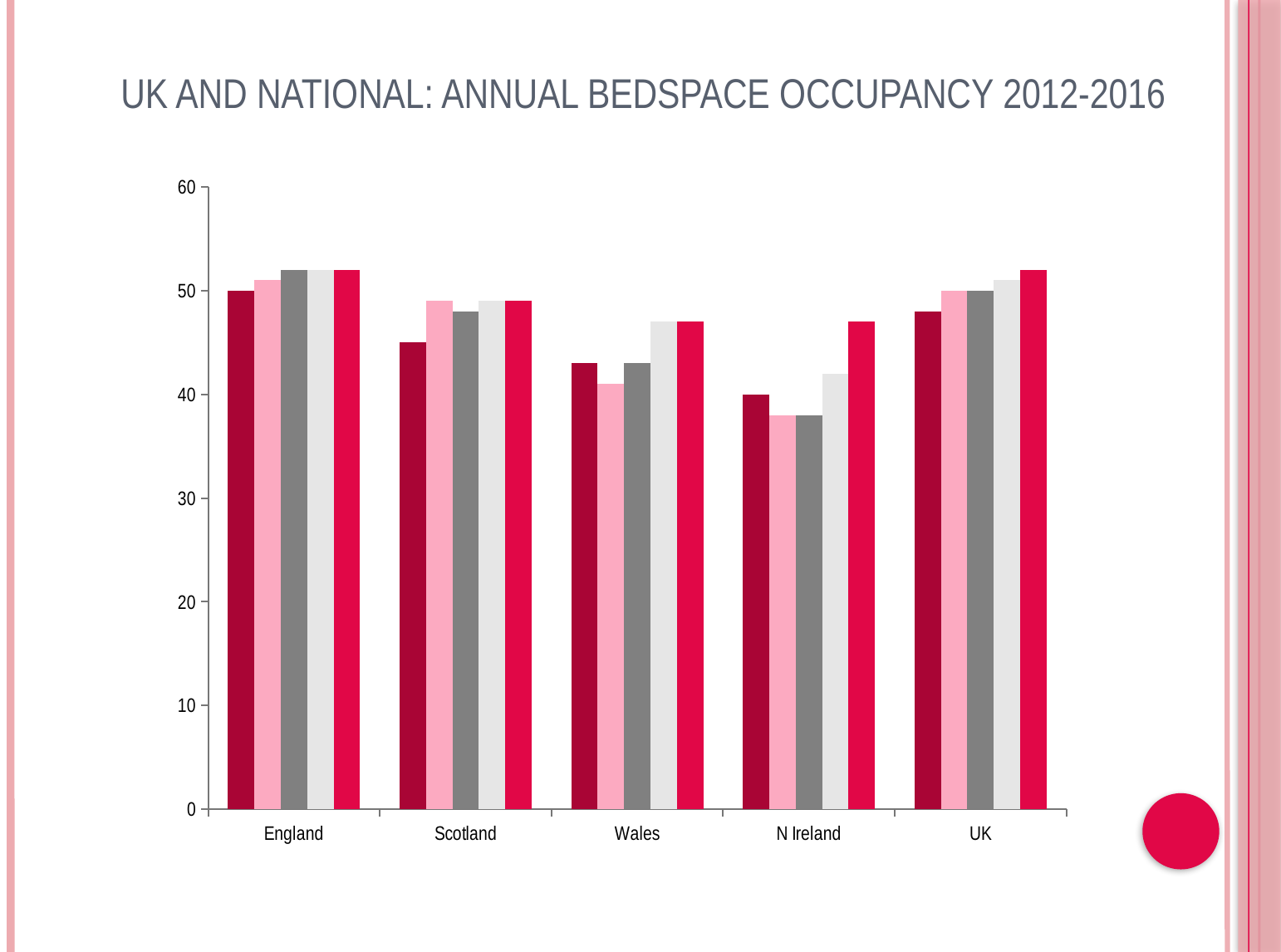
Is the value of the fourth (light grey) bar for Wales greater or less than 50? less How many categories are shown on the x axis? 5 Is the value of the first (dark red) bar for Scotland greater or less than 50? less Is the value of the last (bright red) bar for N Ireland greater or less than 50? less Which is larger: the first (dark red) bar for England or the first (dark red) bar for Scotland? England Within the N Ireland group, is the last bar higher or lower than the first bar? higher What is the title of the chart? UK and National: Annual Bedspace Occupancy 2012-2016 How many bars are plotted for each category? 5 Which category has the lowest bar in the chart? N Ireland Which is larger: the first (dark red) bar for Wales or the first (dark red) bar for N Ireland? Wales What type of chart is shown on the slide? bar chart